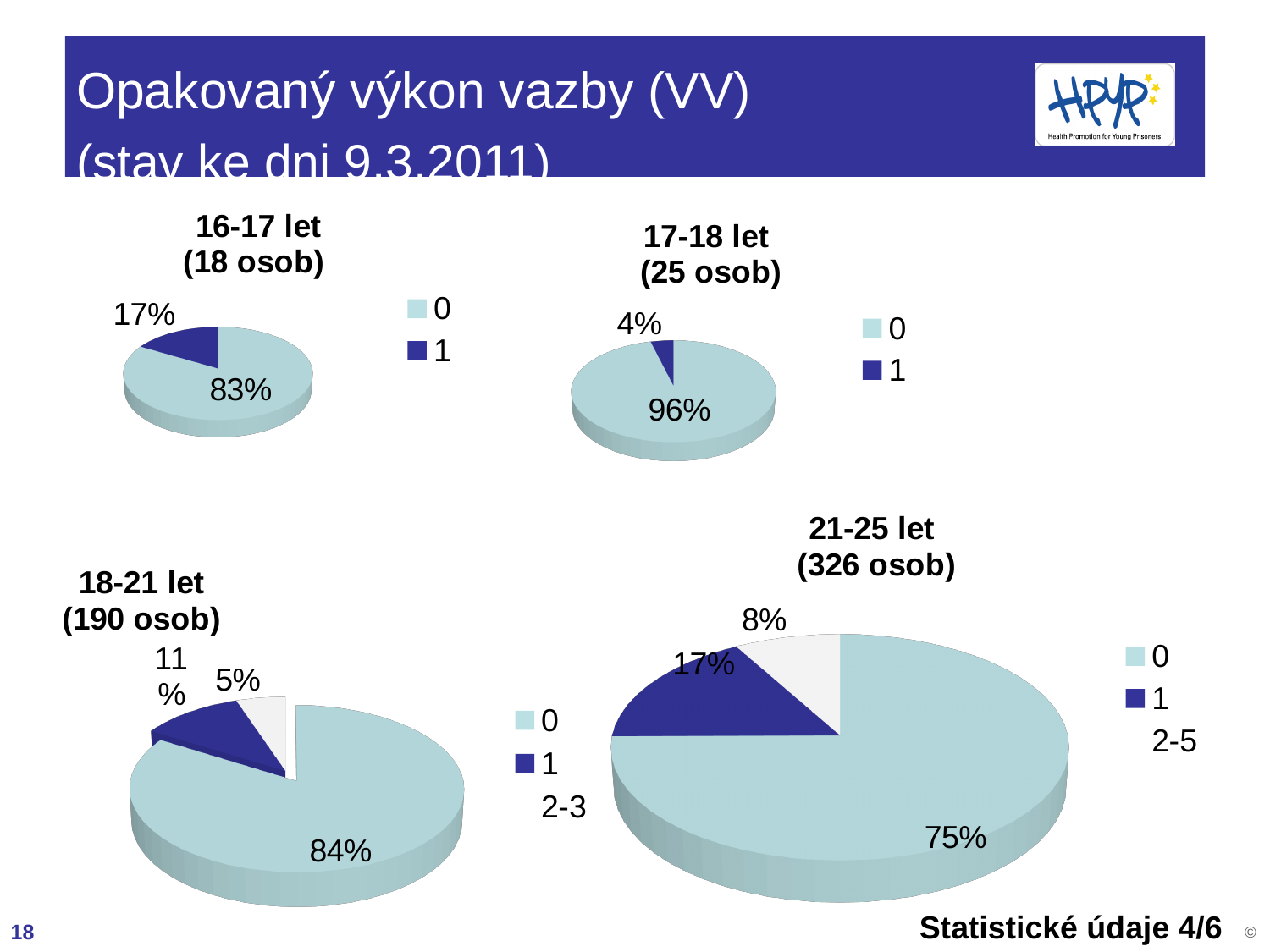
In the "18-21 let (190 osob)" pie chart, what share does the "2-3" slice have? 5% In the "17-18 let (25 osob)" pie chart, what share does the "1" slice have? 4% In the "21-25 let (326 osob)" pie chart, what is the difference between the "0" slice and the "1" slice? 58% In the "21-25 let (326 osob)" pie chart, which slice is the smallest? 2-5 In the "16-17 let (18 osob)" pie chart, what share does the "0" slice have? 83% How many entries does the legend of the "21-25 let (326 osob)" chart list? 3 What kind of chart is the "17-18 let (25 osob)" chart? Pie chart How many slices does the "18-21 let (190 osob)" pie chart have? 3